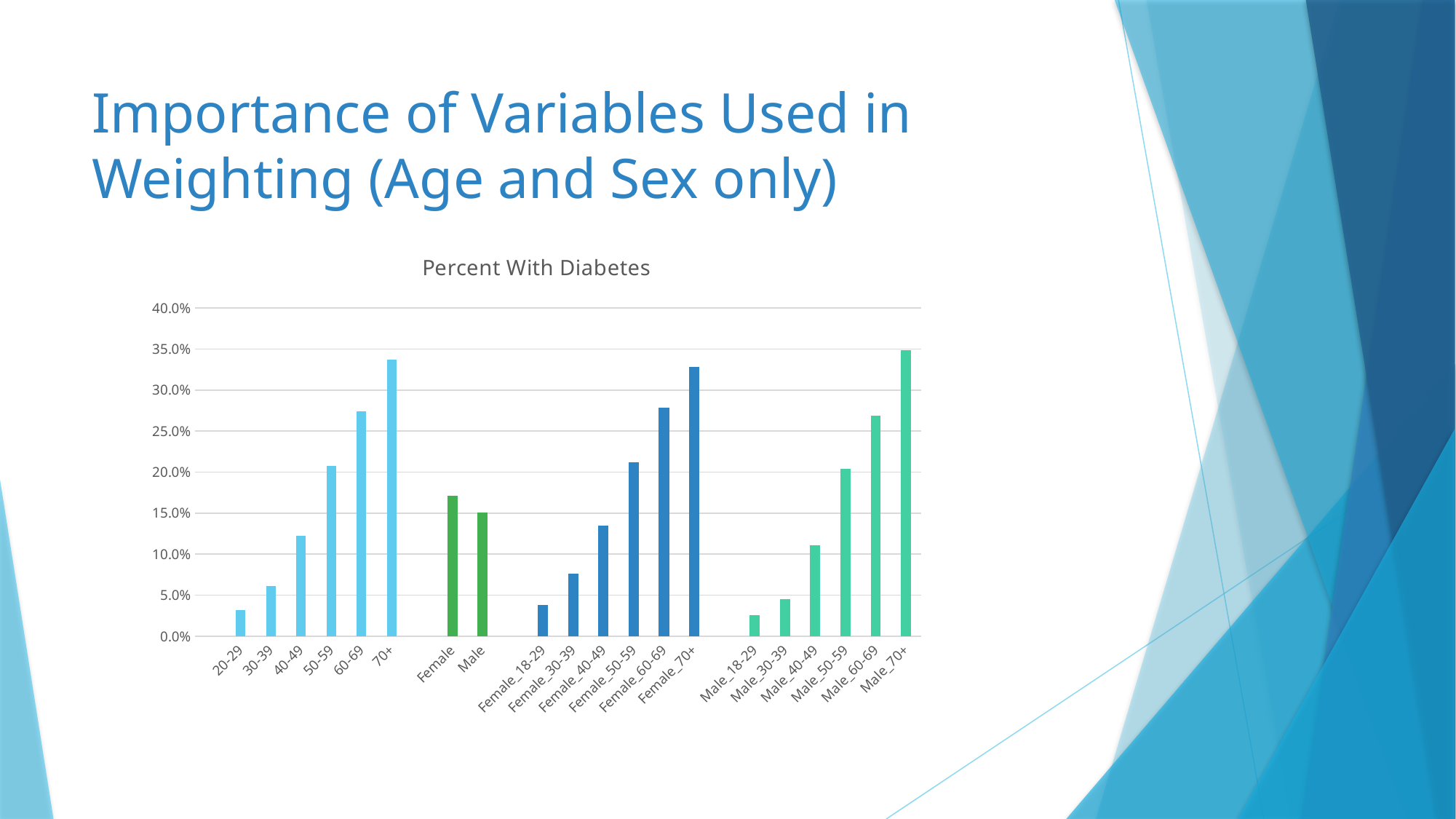
Which is larger, the value for Female_18-29 or the value for Male_18-29? Female_18-29 Do the values rise or fall across the age groups from 20-29 to 70+? Rise Is the value for 20-29 greater or less than 5.0%? less Is the value for Female greater or less than 15.0%? greater Is the value for 70+ greater or less than 30.0%? greater Which is larger, the value for Female or the value for Male? Female What is the title of the chart? Percent With Diabetes What kind of chart is shown on the slide? Bar chart Among the Female_ age-group categories, which has the highest value? Female_70+ How many categories are plotted along the x axis of the chart? 20